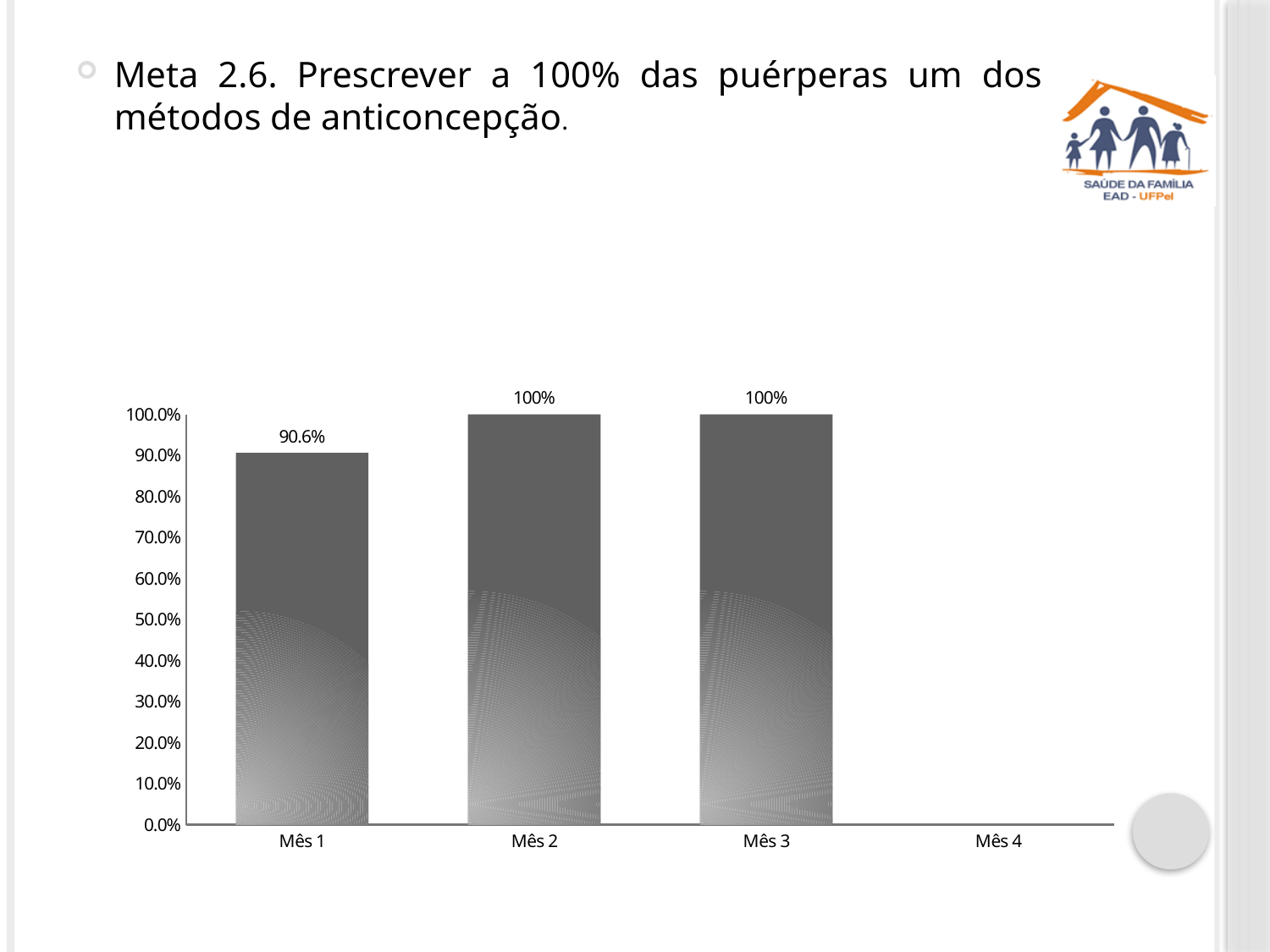
What kind of chart is shown on the slide? Bar chart Which is larger, the value for Mês 1 or the value for Mês 3? Mês 3 Is the value for Mês 1 greater or less than 80.0%? greater What is the value for Mês 1? 90.6% What is the value for Mês 2? 100% What is the difference between the values for Mês 2 and Mês 1? 9.4% Which month on the x axis has no bar plotted? Mês 4 Do the values rise or fall from Mês 1 to Mês 2? Rise How many categories are shown on the x axis? 4 What is the value for Mês 3? 100% Which month has the lowest value among the bars shown? Mês 1 What is the highest value shown on the y axis? 100.0%